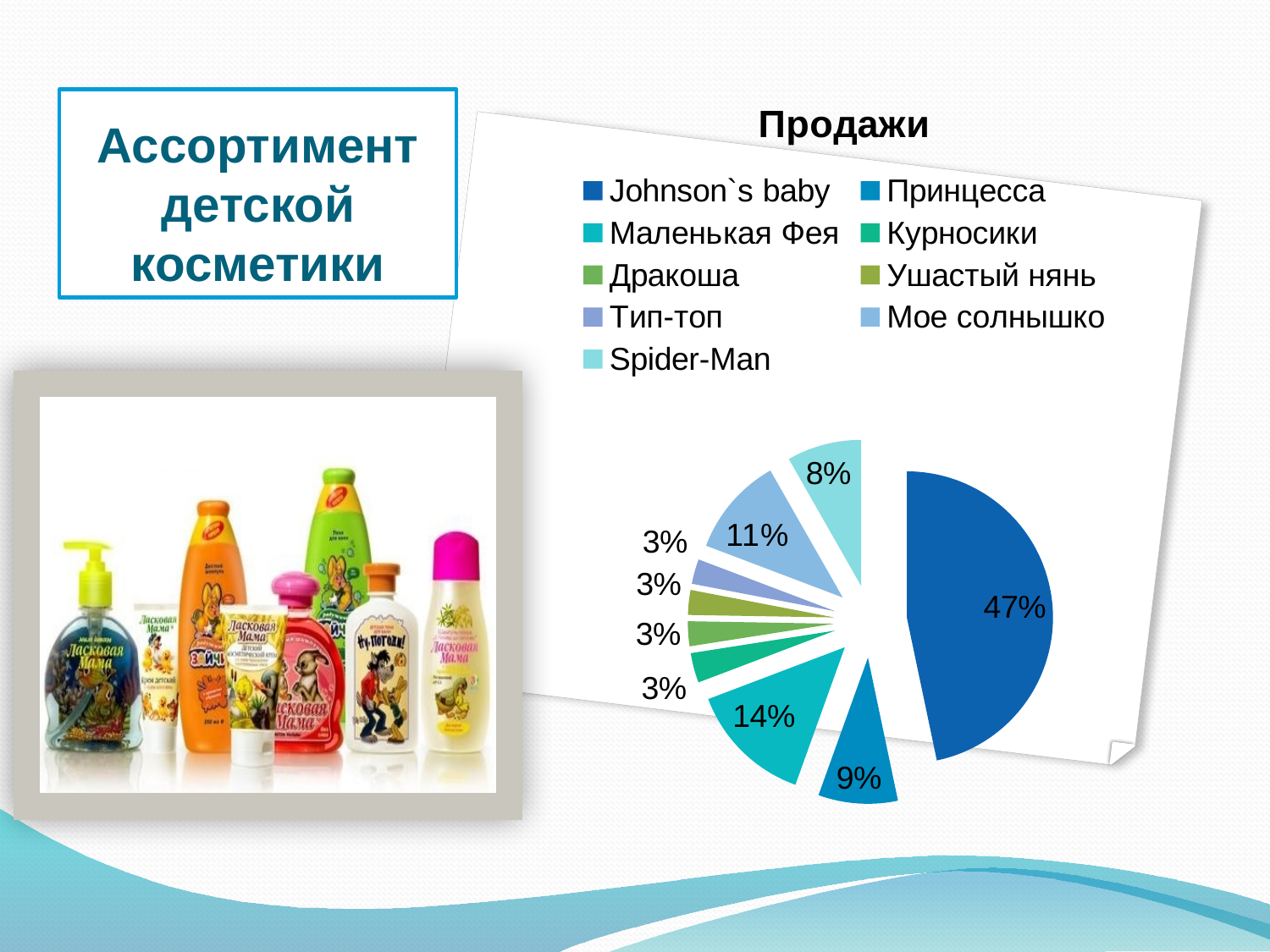
What share of the pie does Принцесса have? 9% What kind of chart is shown on the slide? pie chart What is the title of the chart? Продажи What is the difference in percentage points between the shares of Johnson`s baby and Маленькая Фея? 33 How many slices of the pie are labelled 3%? 4 Which has a larger share, Маленькая Фея or Мое солнышко? Маленькая Фея Which category has the largest share of the pie? Johnson`s baby What share of the pie does Johnson`s baby have? 47% What share of the pie does Spider-Man have? 8% How many categories does the legend of the chart list? 9